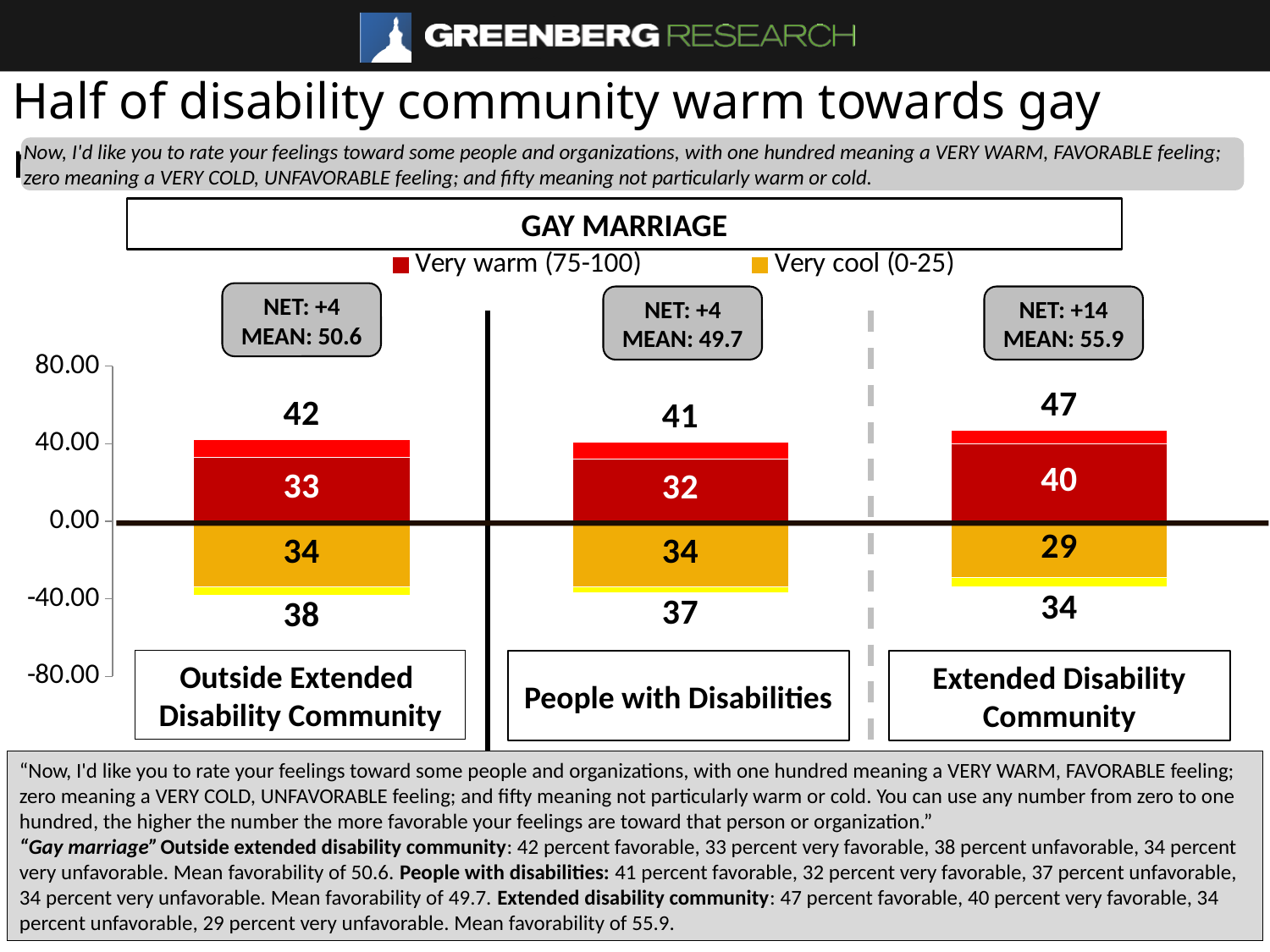
What kind of chart is shown on the slide? bar chart How many series does the chart legend list? 2 Which category has the highest 'Very warm (75-100)' value? Extended Disability Community Which category has the lowest 'Very cool (0-25)' value? Extended Disability Community What is the 'Very warm (75-100)' value for People with Disabilities? 32 What is the 'Very cool (0-25)' value for Extended Disability Community? 29 How many categories are shown along the x axis of the chart? 3 What is the difference between the 'Very warm (75-100)' value for Extended Disability Community and for Outside Extended Disability Community? 7 What MEAN value is shown for Extended Disability Community? 55.9 What is the title of the chart? GAY MARRIAGE Which is larger: the 'Very cool (0-25)' value for People with Disabilities or for Extended Disability Community? People with Disabilities What is the total favorable (warm) value labeled above the bar for Outside Extended Disability Community? 42